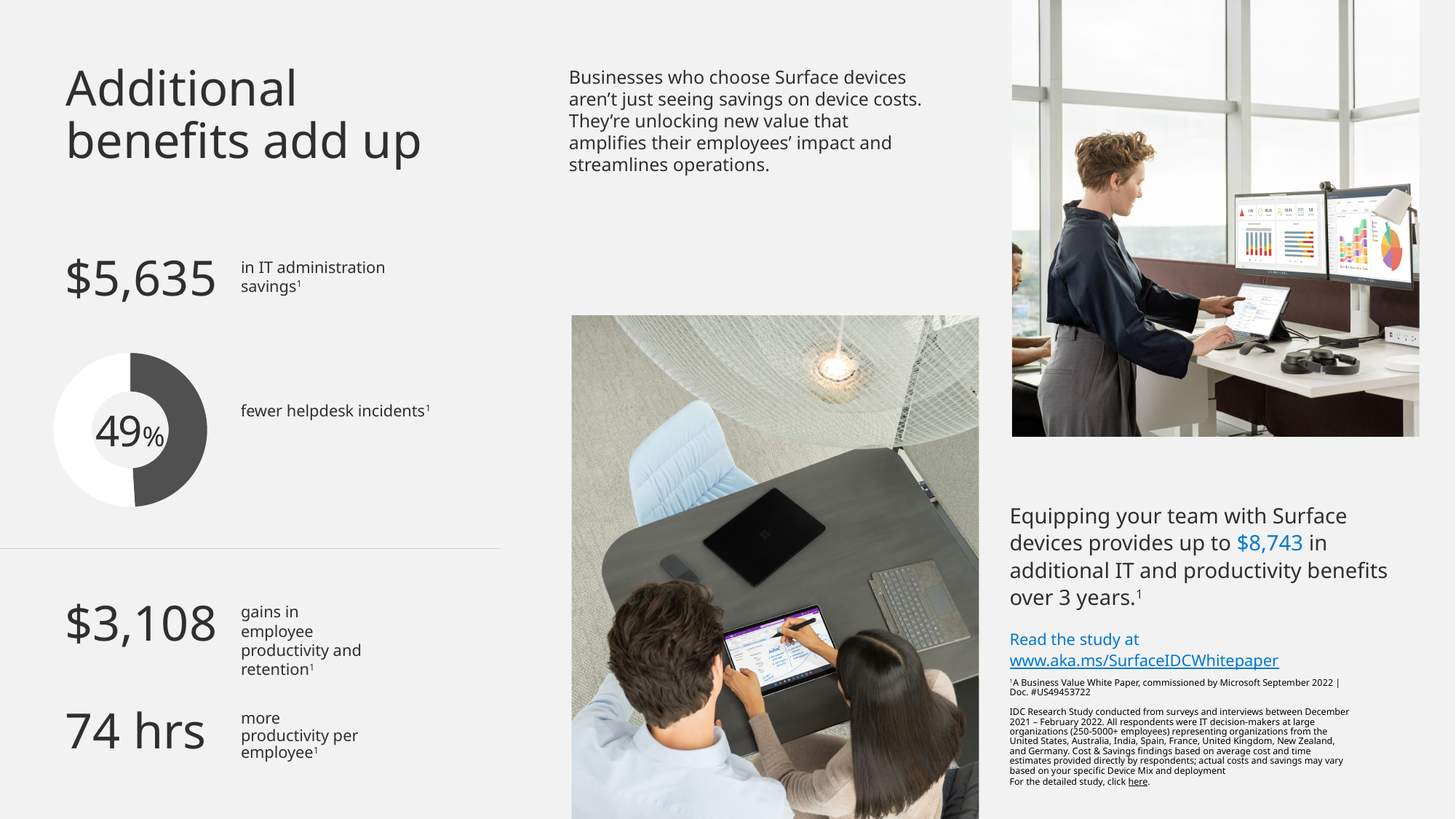
Is the value shown in the donut chart greater or less than 50%? less What percentage is shown in the centre of the donut chart? 49% How many segments does the donut chart have? 2 What share of the donut chart is filled in dark grey? 49% What does the 49% in the donut chart represent? fewer helpdesk incidents What colour is the filled segment of the donut chart? dark grey What kind of chart is used to show the 49% figure? donut chart